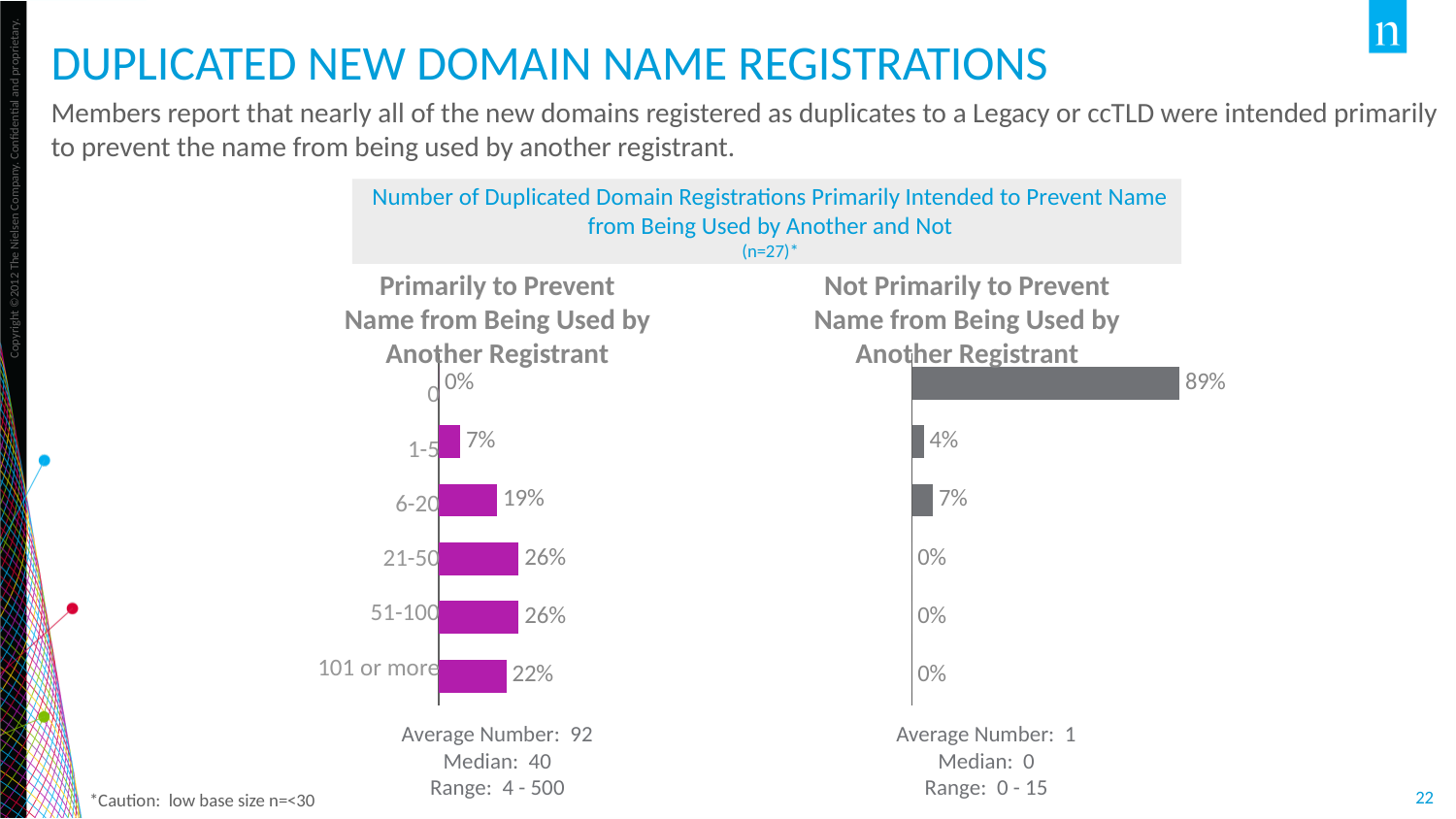
What colour are the bars in the 'Primarily to Prevent Name from Being Used by Another Registrant' chart? Purple/magenta In the 'Primarily to Prevent Name from Being Used by Another Registrant' chart, what is the value for the 1-5 category? 7% In the 'Primarily to Prevent Name from Being Used by Another Registrant' chart, what is the difference between the values for 21-50 and 1-5? 19% In the 'Primarily to Prevent Name from Being Used by Another Registrant' chart, what is the value for the 6-20 category? 19% In the 'Not Primarily to Prevent Name from Being Used by Another Registrant' chart, what is the value of the third bar from the top? 7% In the 'Primarily to Prevent Name from Being Used by Another Registrant' chart, which category has the lowest value? 0 What type of chart is the 'Primarily to Prevent Name from Being Used by Another Registrant' chart? Bar chart How many categories are shown in the 'Primarily to Prevent Name from Being Used by Another Registrant' chart? 6 In the 'Primarily to Prevent Name from Being Used by Another Registrant' chart, which is larger, the value for 6-20 or the value for 101 or more? 101 or more In the 'Not Primarily to Prevent Name from Being Used by Another Registrant' chart, what is the highest value shown? 89% In the 'Not Primarily to Prevent Name from Being Used by Another Registrant' chart, how many bars have a value of 0%? 3 In the 'Primarily to Prevent Name from Being Used by Another Registrant' chart, what is the value for the 101 or more category? 22%